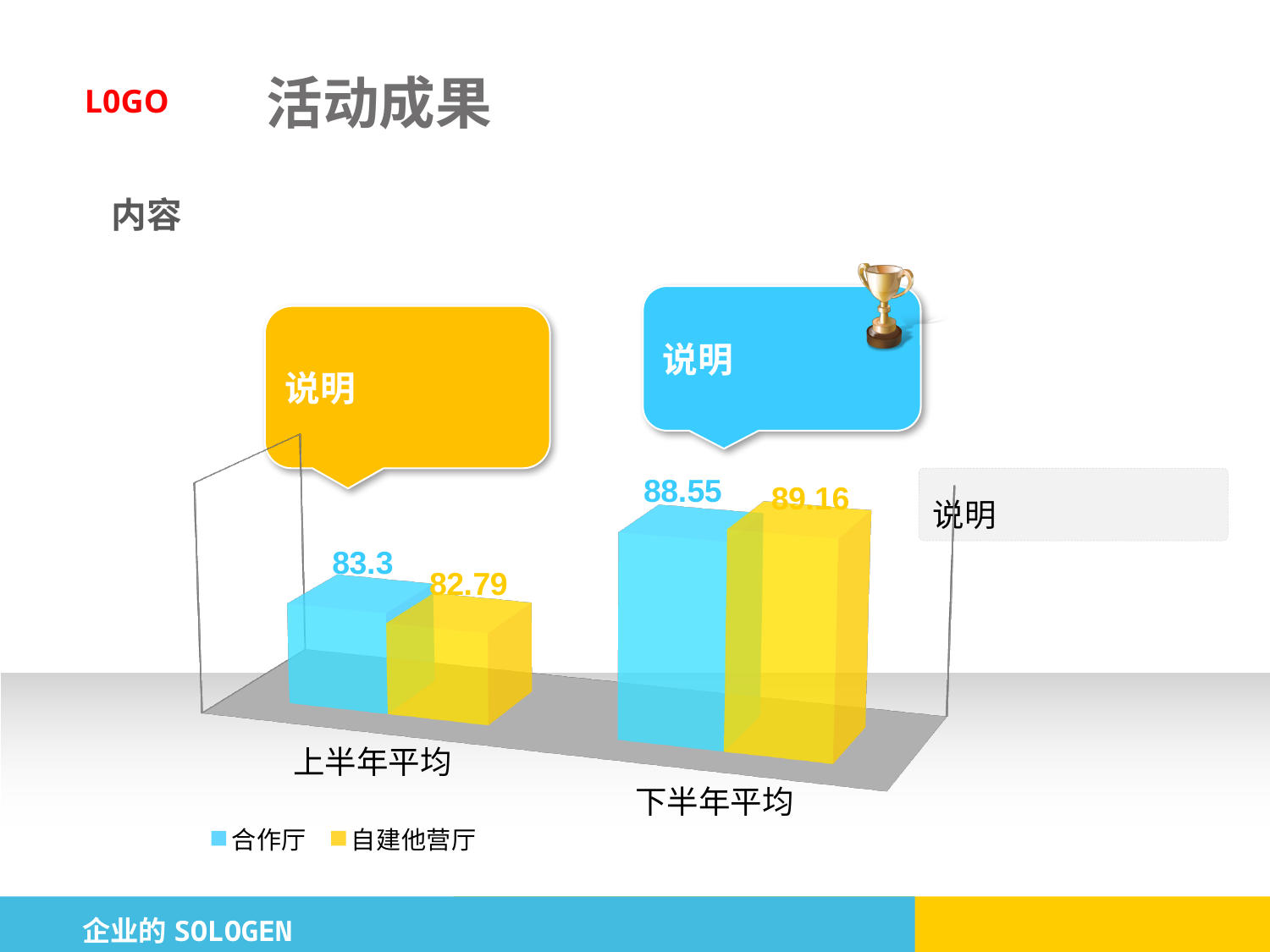
What is the value for 自建他营厅 in 下半年平均? 89.16 What is the value for 合作厅 in 上半年平均? 83.3 What is the value for 合作厅 in 下半年平均? 88.55 What kind of chart is shown on the slide? bar chart Which category has the lowest value for 自建他营厅? 上半年平均 What is the value for 自建他营厅 in 上半年平均? 82.79 What is the difference between the 自建他营厅 values for 下半年平均 and 上半年平均? 6.37 How many categories are shown on the x axis? 2 Which colour represents 自建他营厅 in the chart? yellow Which category has the highest value for 合作厅? 下半年平均 How many series does the legend list? 2 What is the difference between the 合作厅 values for 下半年平均 and 上半年平均? 5.25